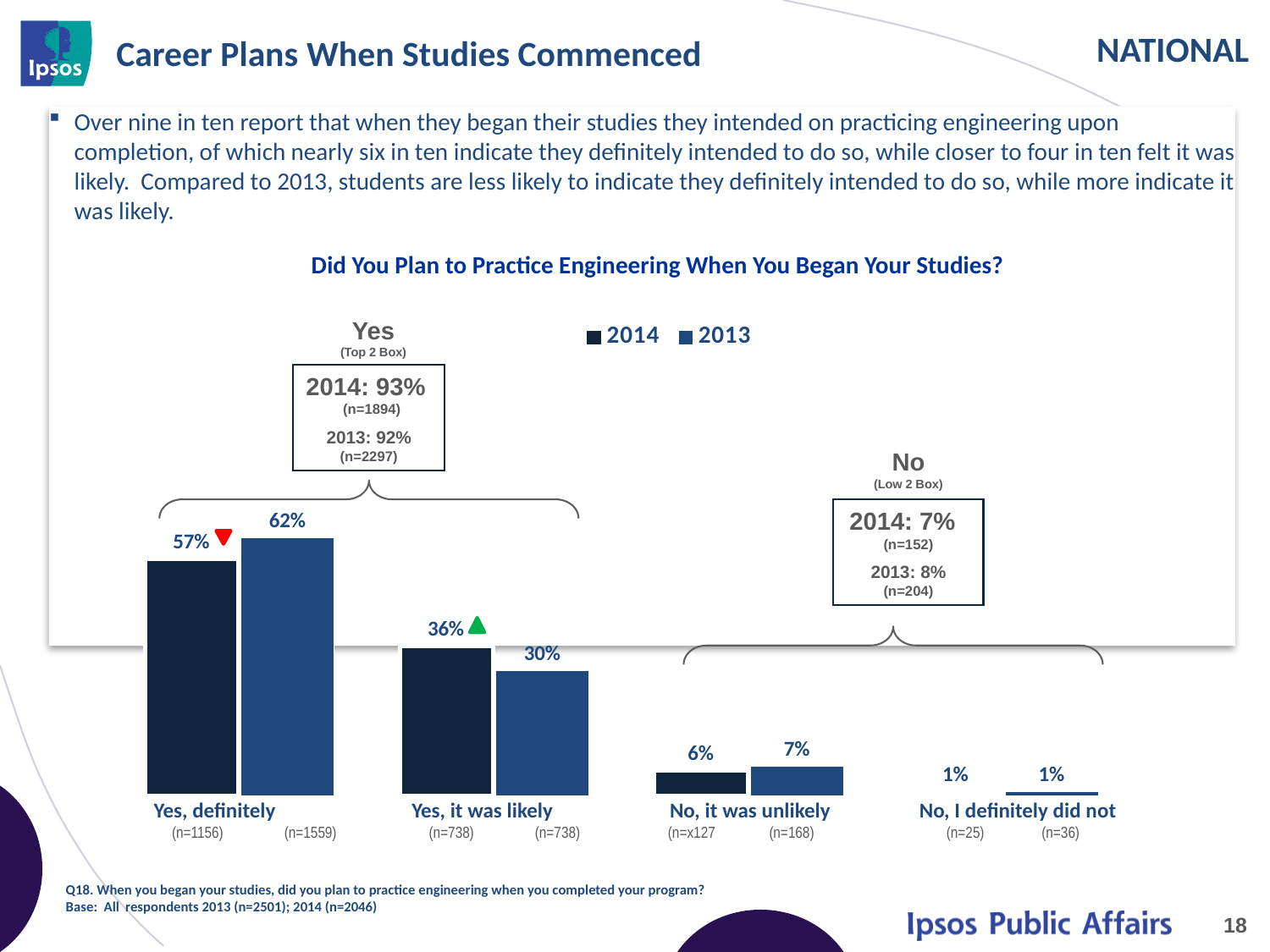
For "Yes, it was likely", which year has the larger value, 2014 or 2013? 2014 Which category has the highest 2013 value? Yes, definitely Which category has the lowest 2014 value? No, I definitely did not What is the 2013 value for "No, it was unlikely"? 7% What is the 2013 value for "Yes, it was likely"? 30% What is the difference between the 2013 and 2014 values for "Yes, definitely"? 5% How many series does the legend list? 2 What is the 2014 value for "Yes, definitely"? 57% What is the difference between the 2014 and 2013 values for "Yes, it was likely"? 6% What kind of chart is shown on the slide? Bar chart How many response categories are shown on the x axis? 4 What is the title of the chart? Did You Plan to Practice Engineering When You Began Your Studies?